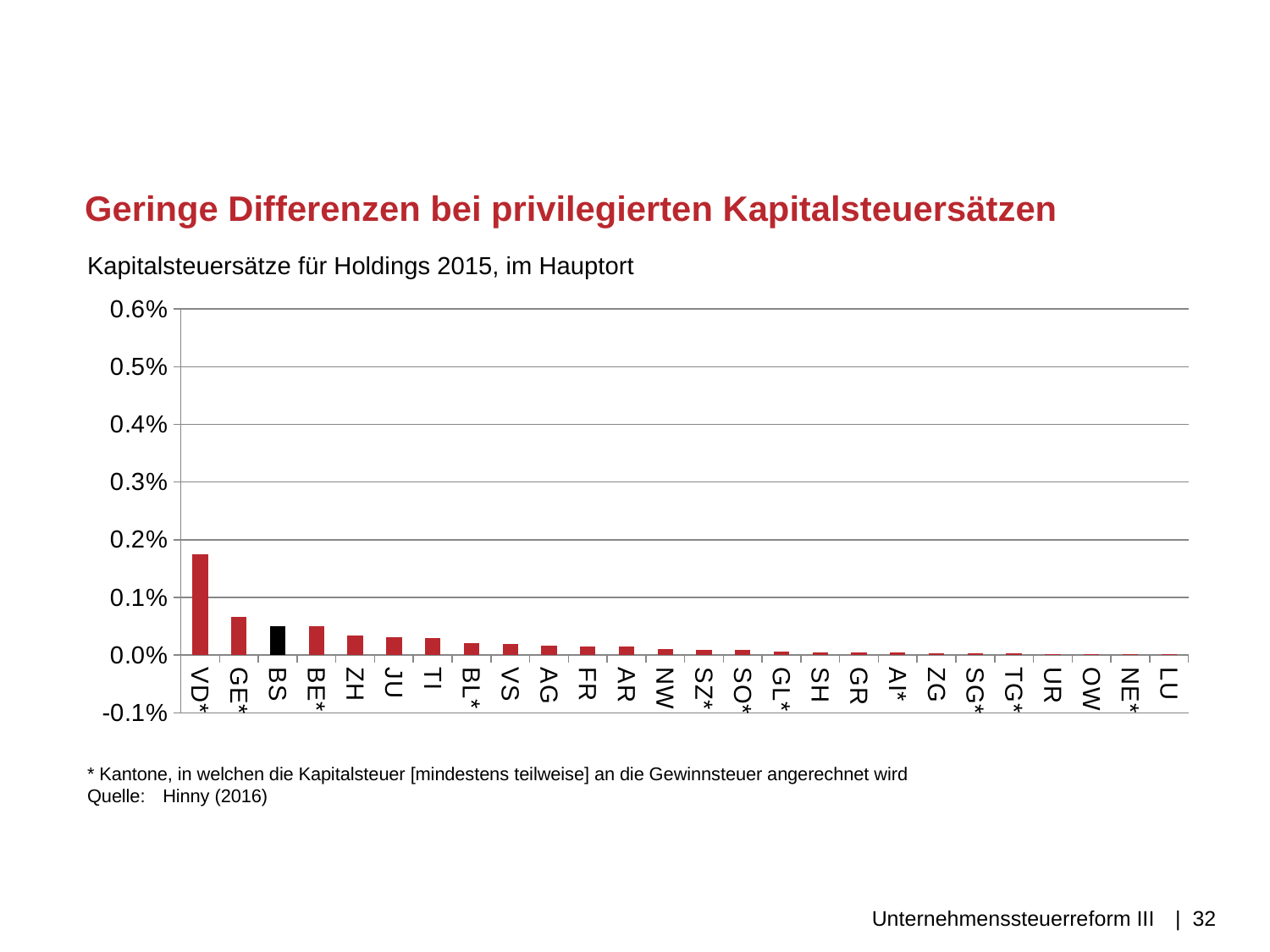
How many cantons are shown on the x axis of the chart? 26 Which is larger, the value for GE* or the value for ZH? GE* What kind of chart is shown on the slide? bar chart Do the values rise or fall from left to right along the x axis? fall What is the subtitle of the chart? Kapitalsteuersätze für Holdings 2015, im Hauptort Is the value for VD* greater or less than 0.2%? less Which canton's bar is coloured black instead of red? BS Is the value for VD* greater or less than 0.1%? greater Which is larger, the value for VD* or the value for GE*? VD* Is the value for BS greater or less than 0.1%? less Which canton has the highest Kapitalsteuersatz in the chart? VD*